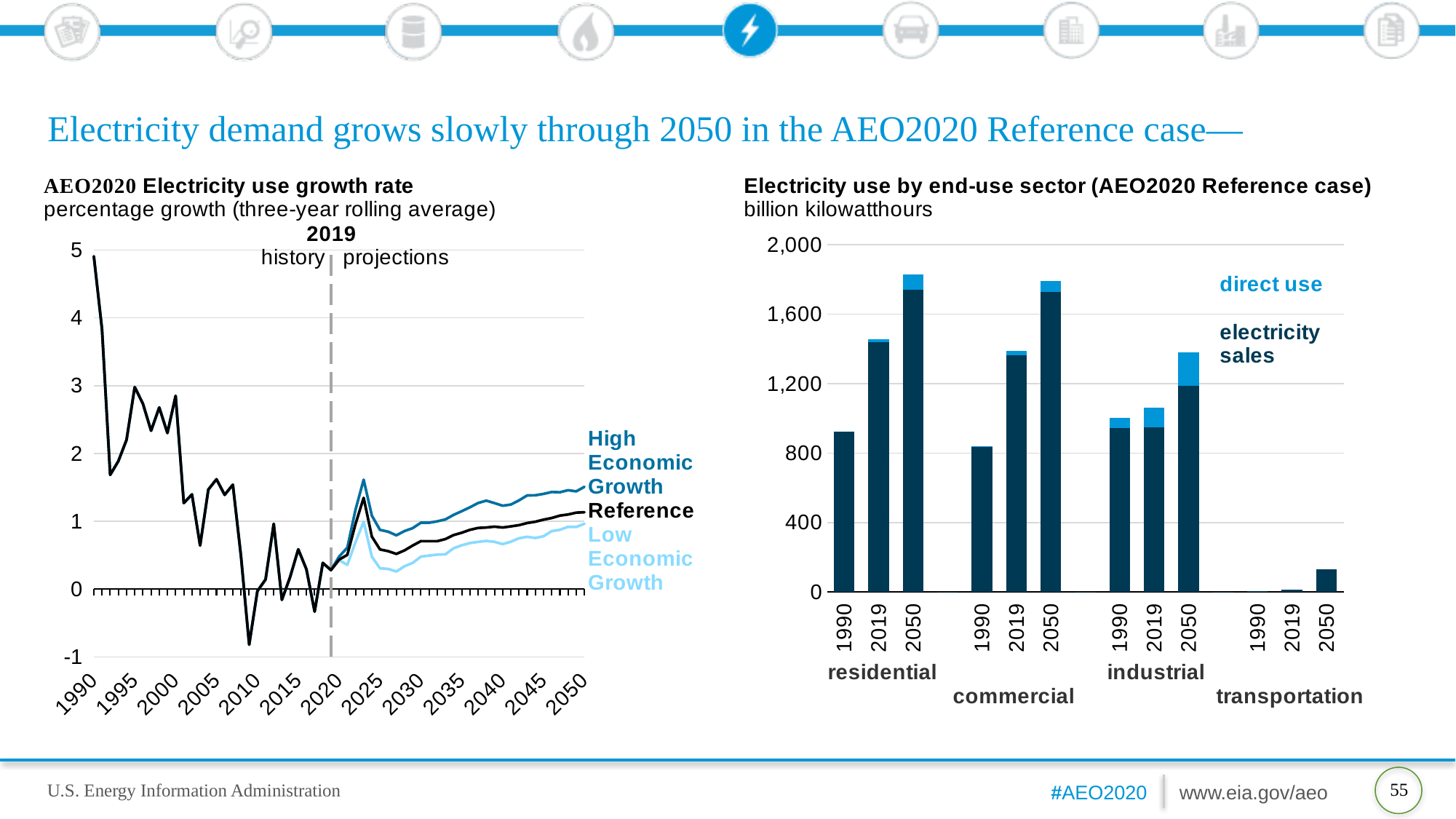
How many series are shown on the left chart, 'AEO2020 Electricity use growth rate'? 3 On the left chart, 'AEO2020 Electricity use growth rate', is the Low Economic Growth value in 2030 greater or less than 1? less On the left chart, 'AEO2020 Electricity use growth rate', is the value in 1990 greater or less than 4? greater On the left chart, 'AEO2020 Electricity use growth rate', what year does the dashed line separating history from projections mark? 2019 On the right chart, 'Electricity use by end-use sector (AEO2020 Reference case)', which bar is the tallest? residential 2050 On the left chart, 'AEO2020 Electricity use growth rate', which is larger in 2050: High Economic Growth or Low Economic Growth? High Economic Growth What kind of chart is the right chart, 'Electricity use by end-use sector (AEO2020 Reference case)'? stacked bar chart On the left chart, 'AEO2020 Electricity use growth rate', is the Reference value in 2050 greater or less than 1? greater On the right chart, 'Electricity use by end-use sector (AEO2020 Reference case)', which is larger in 2050: commercial or industrial? commercial How many series does the legend list on the right chart, 'Electricity use by end-use sector (AEO2020 Reference case)'? 2 What kind of chart is the left chart, 'AEO2020 Electricity use growth rate'? line chart